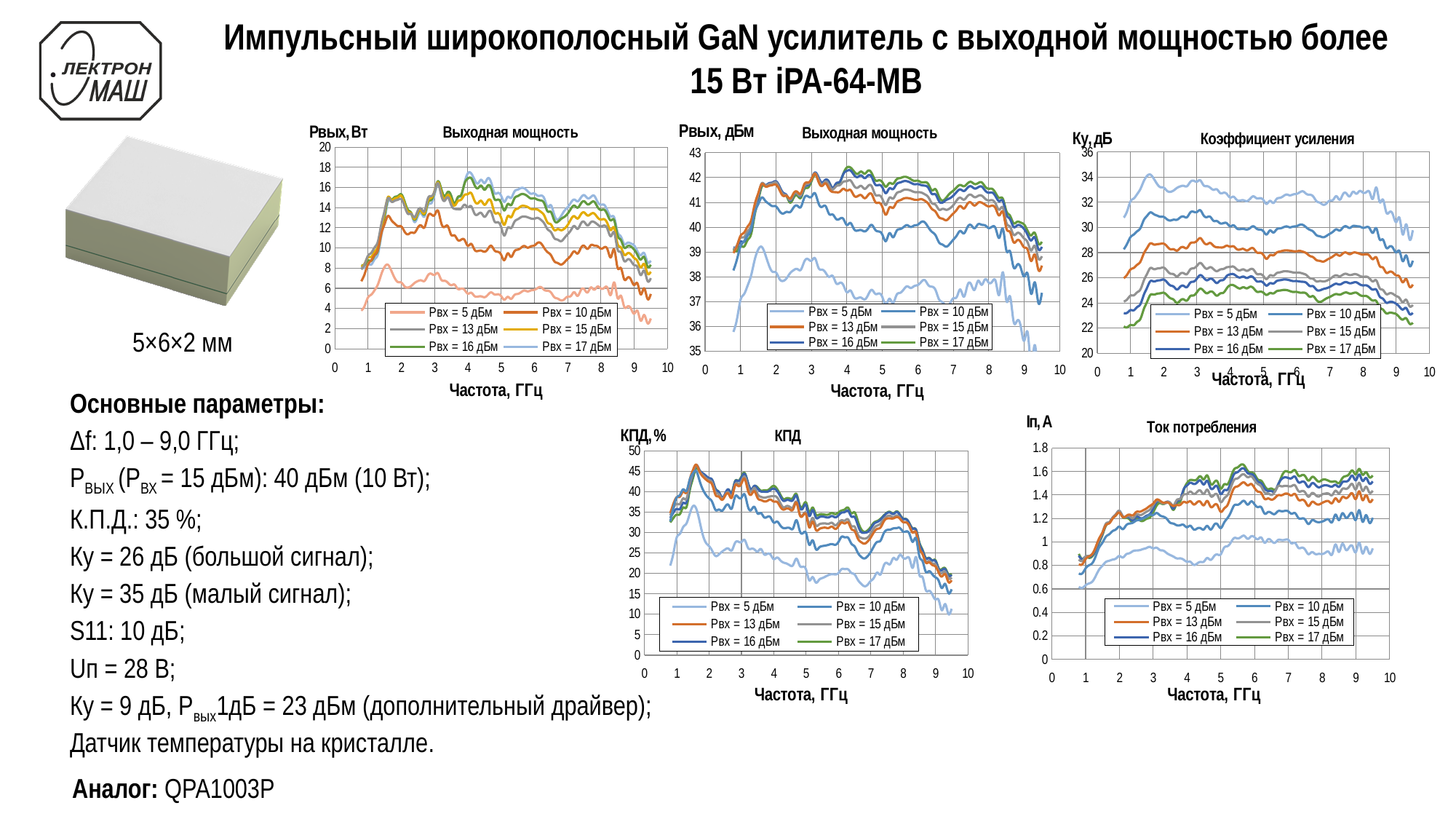
In the 'Ток потребления' chart, is the value for Рвх = 5 дБм at 9 ГГц greater or less than 1.2? less In the 'Коэффициент усиления' chart, which series has the higher gain at 2 ГГц: Рвх = 5 дБм or Рвх = 17 дБм? Рвх = 5 дБм What are the legend entries of the 'Ток потребления' chart? Рвх = 5 дБм, Рвх = 10 дБм, Рвх = 13 дБм, Рвх = 15 дБм, Рвх = 16 дБм, Рвх = 17 дБм How many charts are shown on the slide? 5 In the 'Ток потребления' chart, is the value for Рвх = 17 дБм at 6 ГГц greater or less than 1.4? greater In the 'Выходная мощность' chart with y-axis 'Рвых, дБм', is the value for Рвх = 17 дБм at 4 ГГц greater or less than 41? greater What kind of chart is the 'Выходная мощность' chart with the y-axis labelled 'Рвых, Вт'? line chart How many series does the legend of the 'КПД' chart list? 6 In the 'Коэффициент усиления' chart, does the Рвх = 5 дБм series rise or fall between 8 and 9.5 ГГц? fall In the 'Выходная мощность' chart with y-axis 'Рвых, Вт', which series has the lowest output power across the band? Рвх = 5 дБм What is the x-axis label of the 'КПД' chart? Частота, ГГц